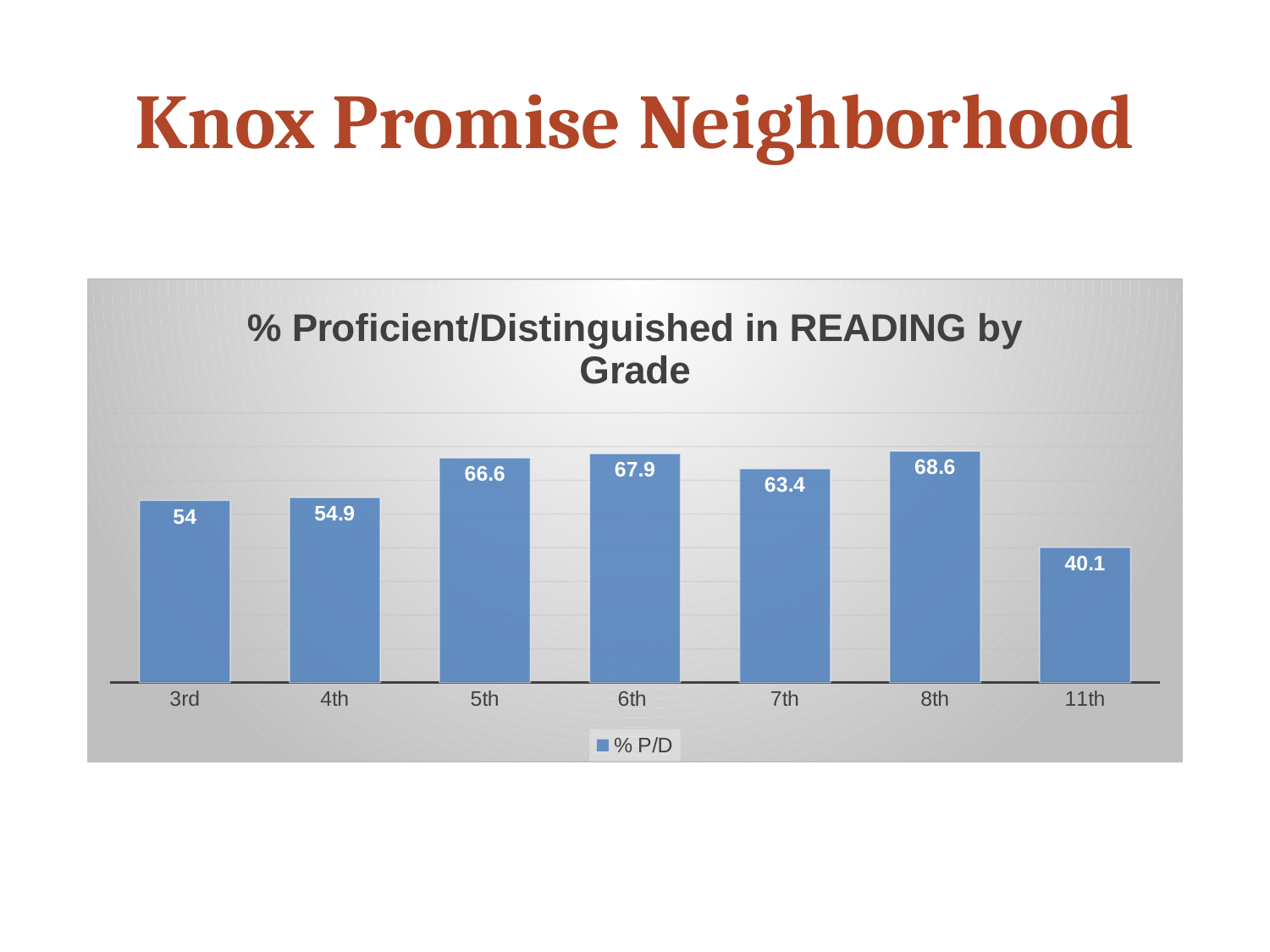
What is the title of the chart? % Proficient/Distinguished in READING by Grade What is the % P/D value for 11th grade? 40.1 What is the difference between the 5th grade and 4th grade values? 11.7 Which is larger, the value for 7th grade or the value for 6th grade? 6th What kind of chart is shown on the slide? Bar chart Which grade has the highest % Proficient/Distinguished in reading? 8th How many grades are shown on the chart? 7 What is the % P/D value for 6th grade? 67.9 Which grade has the lowest % Proficient/Distinguished in reading? 11th What is the % P/D value for 3rd grade? 54 What is the difference between the 8th grade and 11th grade values? 28.5 How many series does the legend list? 1